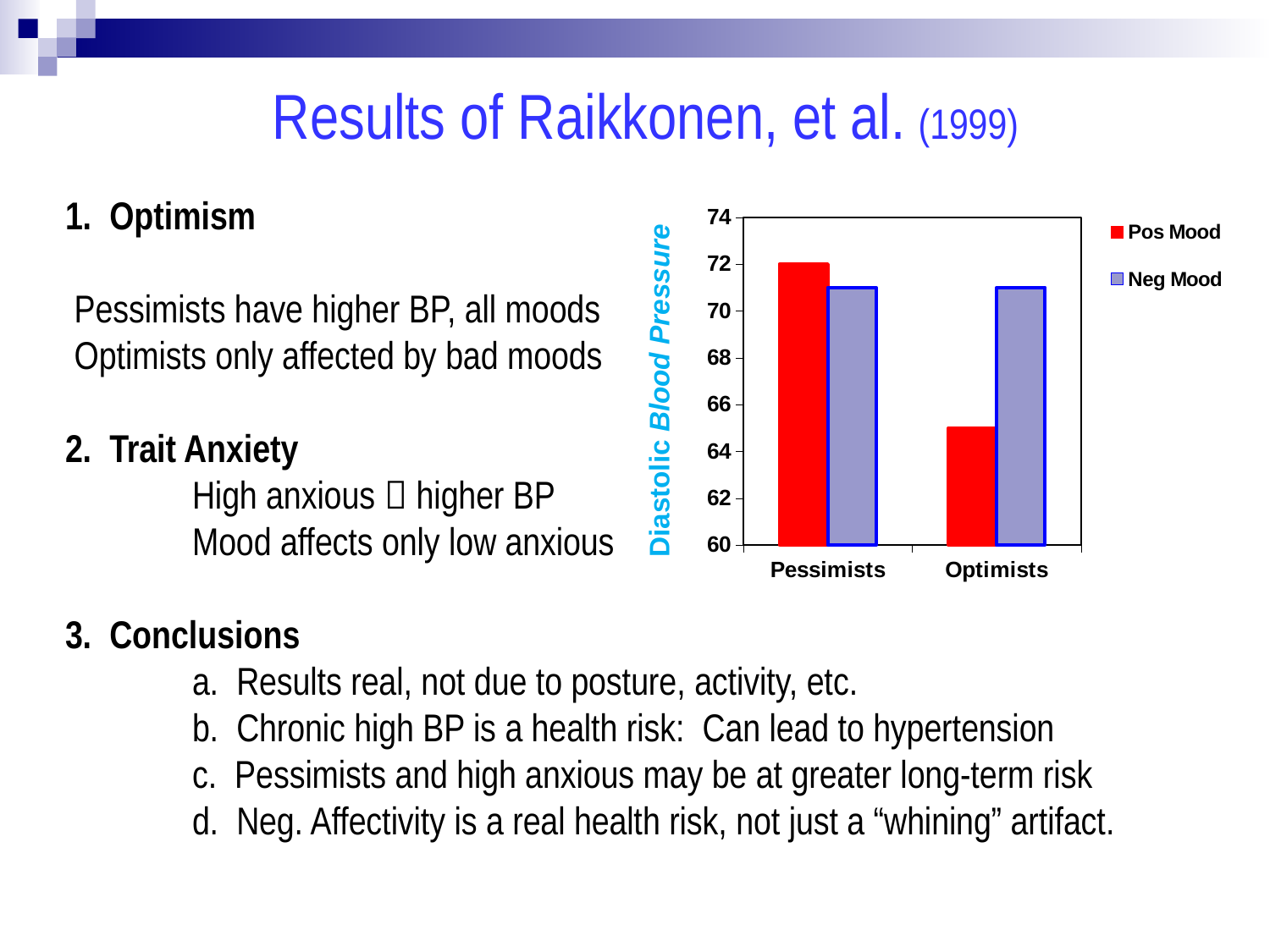
What are the two series named in the chart's legend? Pos Mood and Neg Mood For Optimists, which is larger: the Pos Mood bar or the Neg Mood bar? Neg Mood Is the Pos Mood value for Pessimists greater or less than 70? greater How many series does the chart's legend list? 2 What is the title of the chart's vertical axis? Diastolic Blood Pressure How many categories are shown on the x axis of the chart? 2 For Pos Mood, which group has the larger value: Pessimists or Optimists? Pessimists Is the Pos Mood value for Optimists greater or less than 66? less Is the Neg Mood value for Optimists greater or less than 68? greater Which bar in the chart is the lowest? Optimists, Pos Mood Which bar in the chart is the highest? Pessimists, Pos Mood What kind of chart is shown on the slide? bar chart